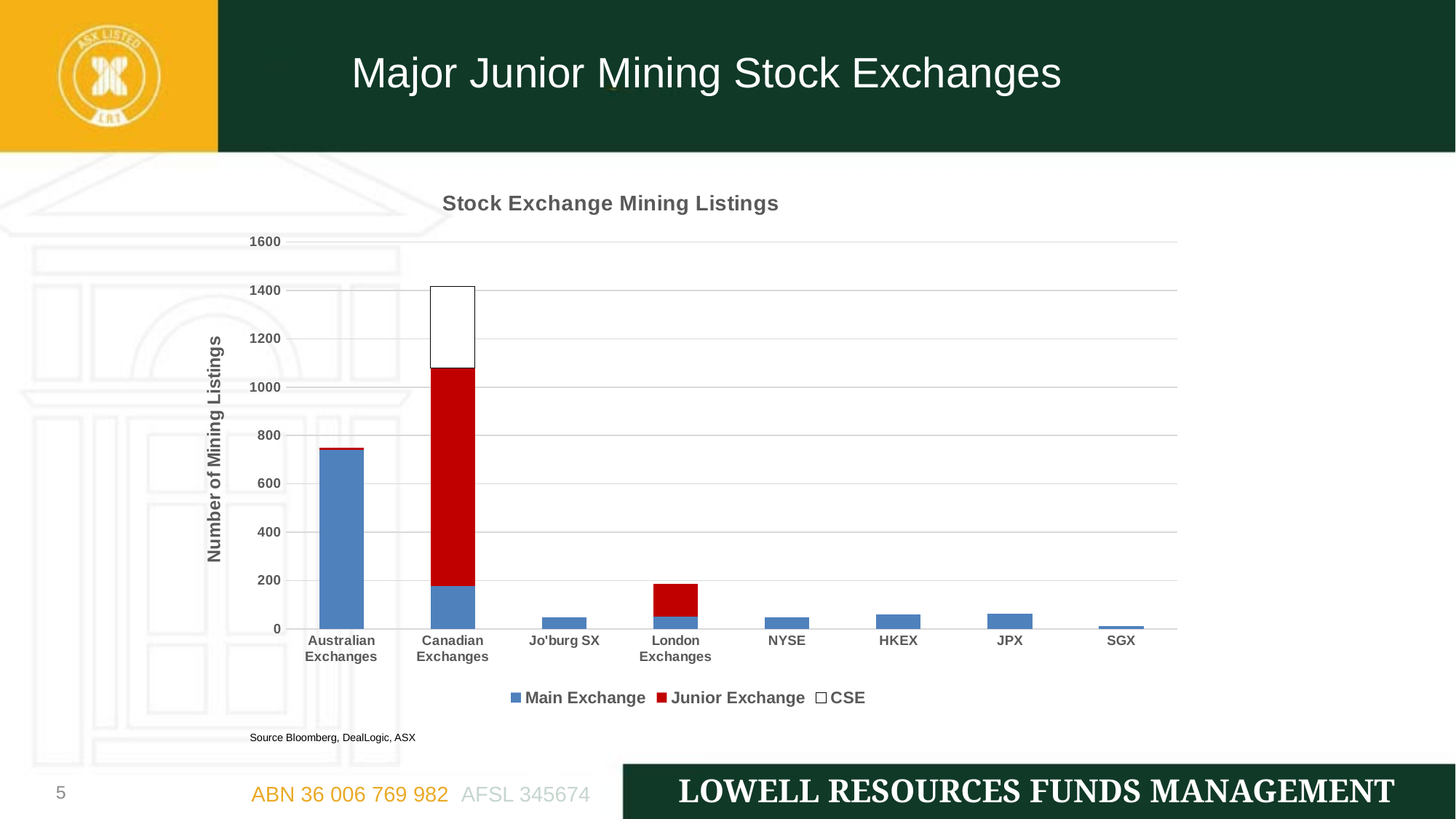
What is the label on the vertical axis of the chart? Number of Mining Listings Is the total value for Canadian Exchanges greater or less than 1200? greater What is the title of the chart? Stock Exchange Mining Listings How many exchange categories are shown on the x axis? 8 Which has more total mining listings, Australian Exchanges or London Exchanges? Australian Exchanges How many series does the legend list? 3 Is the total value for Australian Exchanges greater or less than 600? greater Which exchange category has the lowest total number of mining listings? SGX What type of chart is shown on the slide? Stacked bar chart Which exchange category has the highest total number of mining listings? Canadian Exchanges